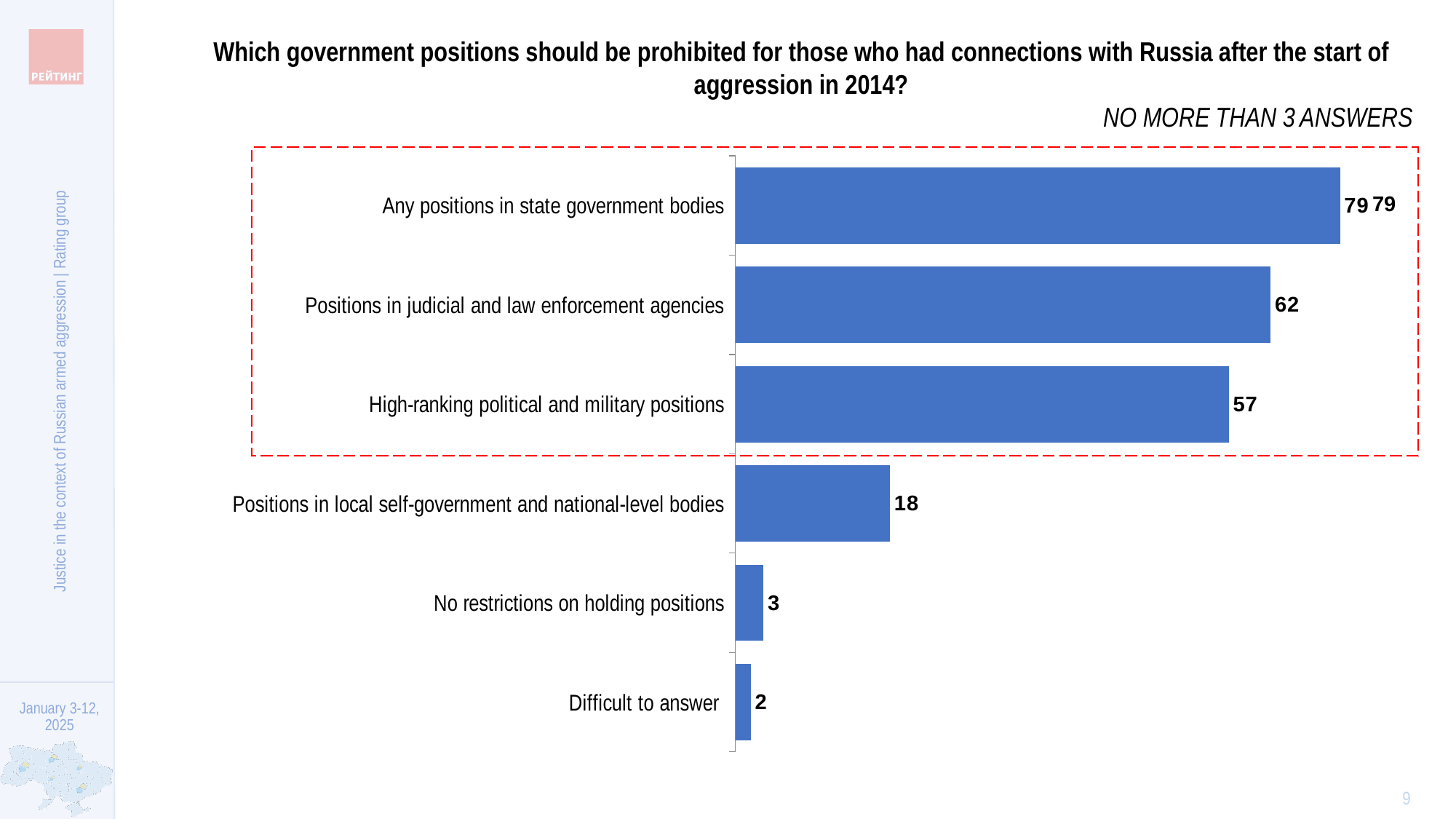
What is the difference between the values for 'Any positions in state government bodies' and 'Positions in judicial and law enforcement agencies'? 17 What kind of chart is shown on the slide? Bar chart How many categories are shown in the chart? 6 What is the value for 'No restrictions on holding positions'? 3 What is the value for 'Any positions in state government bodies'? 79 What is the value for 'Positions in judicial and law enforcement agencies'? 62 Which category has the highest value? Any positions in state government bodies What is the value for 'Positions in local self-government and national-level bodies'? 18 Which is larger: the value for 'High-ranking political and military positions' or 'Positions in local self-government and national-level bodies'? High-ranking political and military positions How many categories are enclosed by the red dashed box? 3 What is the value for 'High-ranking political and military positions'? 57 Which category has the lowest value? Difficult to answer